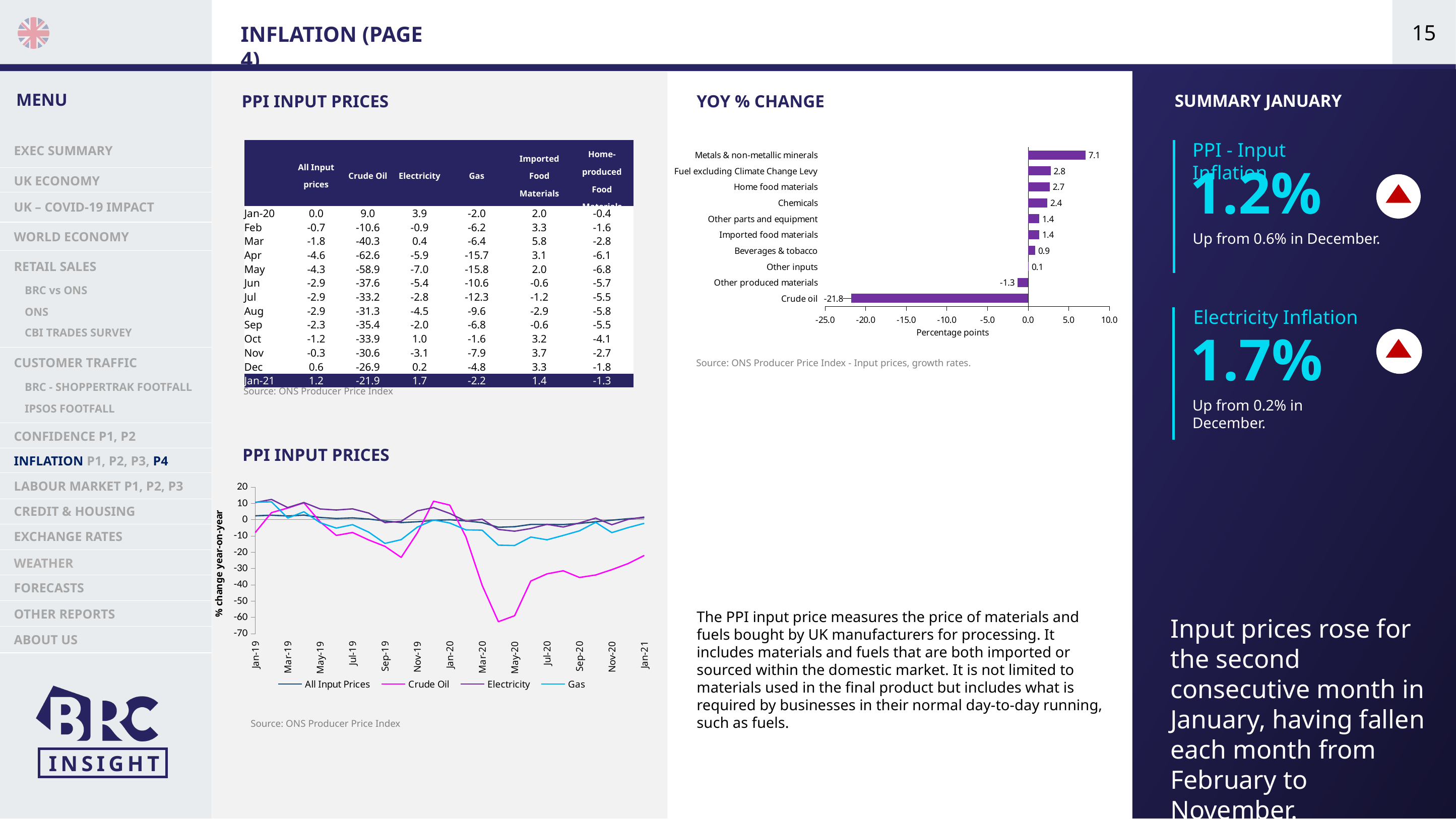
On the PPI INPUT PRICES line chart, is the value for Crude Oil at Apr-20 greater or less than -50? less On the YOY % CHANGE chart, what is the value for Crude oil? -21.8 On the YOY % CHANGE chart, which category has the highest value? Metals & non-metallic minerals How many series does the legend of the PPI INPUT PRICES line chart list? 4 On the PPI INPUT PRICES line chart, does the Crude Oil series rise or fall between Apr-20 and Jan-21? Rise How many categories are shown on the YOY % CHANGE chart? 10 On the YOY % CHANGE chart, what is the value for Metals & non-metallic minerals? 7.1 What kind of chart is the YOY % CHANGE chart? Bar chart On the YOY % CHANGE chart, what is the difference between Fuel excluding Climate Change Levy and Chemicals? 0.4 On the YOY % CHANGE chart, which category has the lowest value? Crude oil On the YOY % CHANGE chart, which is larger, Home food materials or Other produced materials? Home food materials On the YOY % CHANGE chart, what is the value for Beverages & tobacco? 0.9